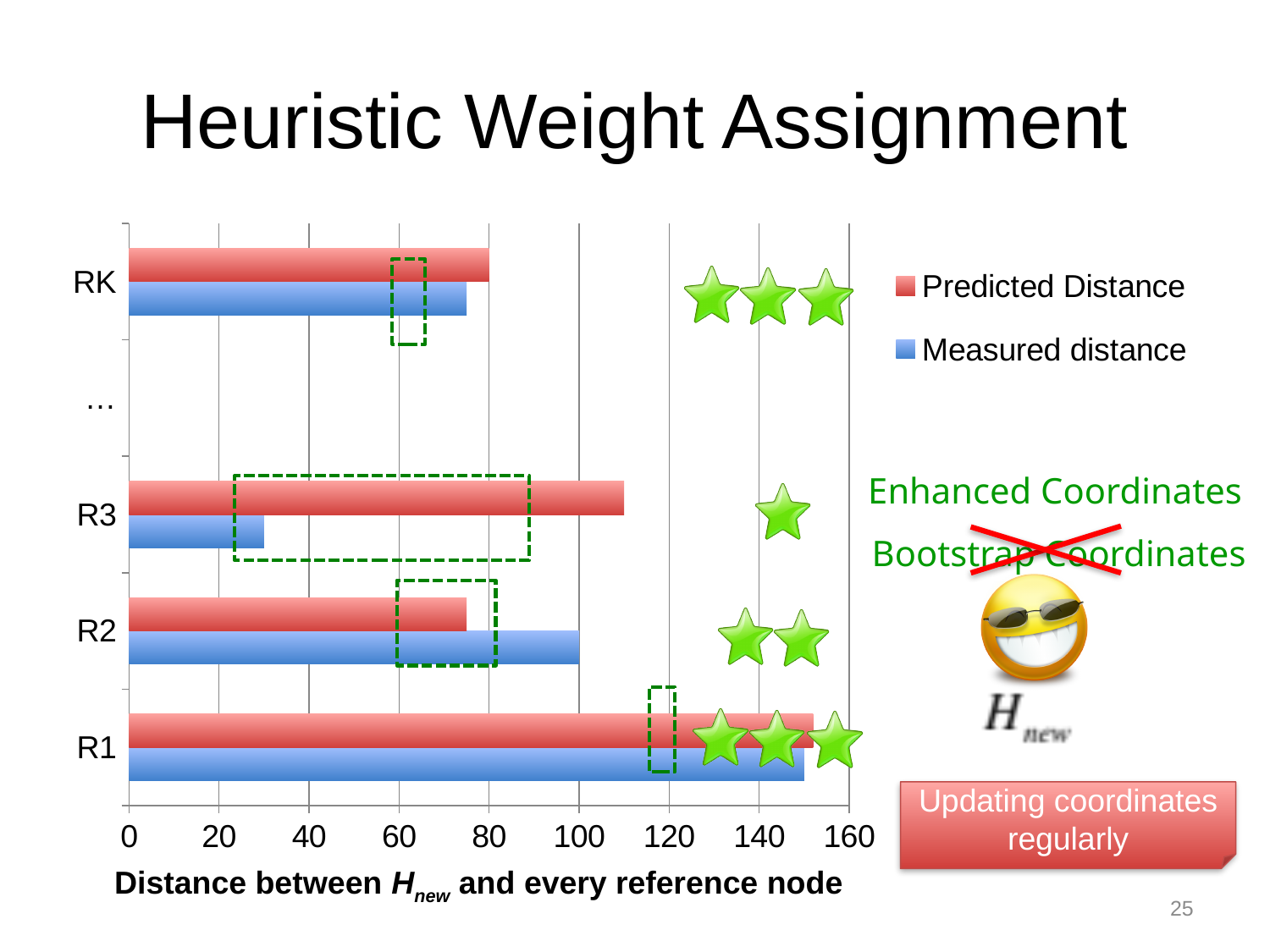
For R3, which is larger: the Predicted Distance or the Measured distance? Predicted Distance What is the Measured distance value for R2? 100 Is the Measured distance for R3 greater or less than 40? less Which reference node has the highest Predicted Distance? R1 What type of chart is shown on the slide? bar chart What colour represents the Predicted Distance series in the chart? red How many series does the chart legend list? 2 For R2, which is larger: the Predicted Distance or the Measured distance? Measured distance Is the Predicted Distance for R3 greater or less than 100? greater Is the Predicted Distance for R1 greater or less than 140? greater Which reference node has the lowest Measured distance? R3 What is the Predicted Distance value for RK? 80